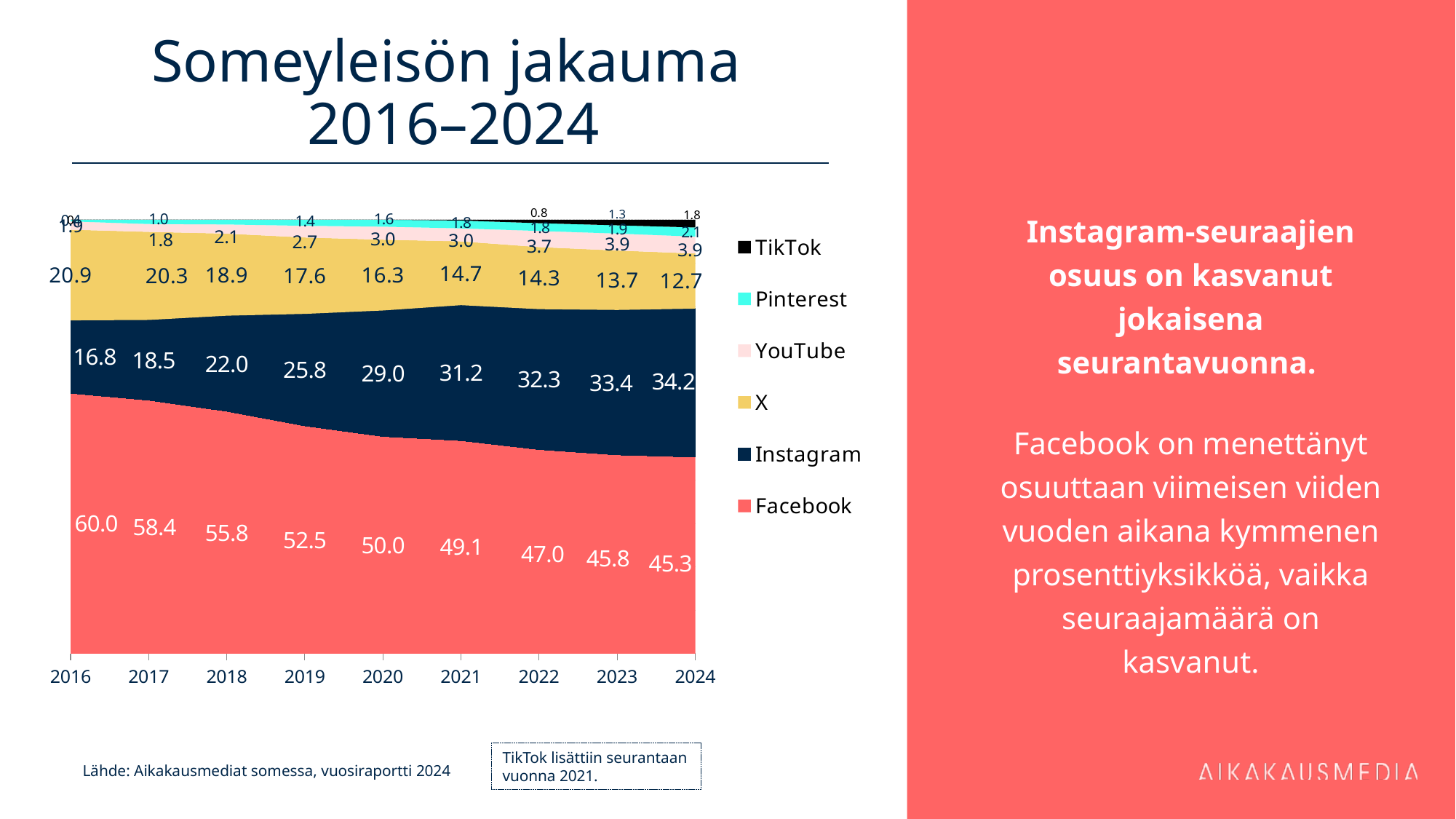
How many years are shown along the x axis? 9 What is the Facebook value for 2016? 60.0 In which year is the Facebook value lowest? 2024 Which is larger in 2024, the Instagram value or the X value? Instagram How many series does the legend list? 6 What is the X value for 2020? 16.3 What is the difference between the Facebook values for 2016 and 2024? 14.7 What kind of chart is shown on the slide? Stacked area chart What is the TikTok value for 2022? 0.8 In which year is the Instagram value highest? 2024 What is the Instagram value for 2024? 34.2 Does the Instagram series rise or fall from 2016 to 2024? Rise